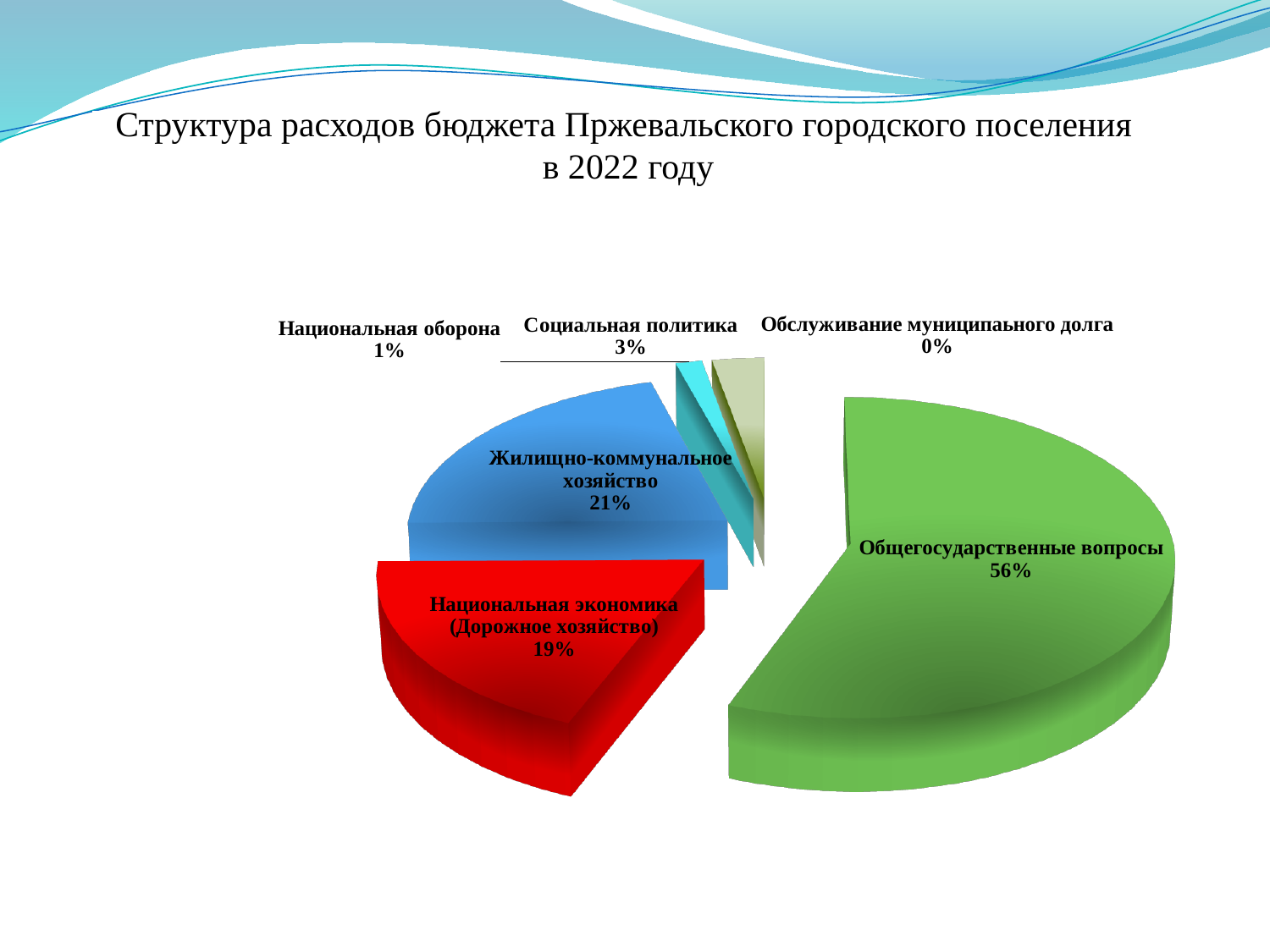
What share of the budget expenditure goes to Общегосударственные вопросы? 56% What is the difference in percentage points between Общегосударственные вопросы and Жилищно-коммунальное хозяйство? 35 Which category has the largest share of the budget expenditure? Общегосударственные вопросы What share of the budget expenditure goes to Жилищно-коммунальное хозяйство? 21% How many categories are shown in the pie chart? 6 What share of the budget expenditure goes to Национальная оборона? 1% What colour is the slice for Национальная экономика (Дорожное хозяйство)? Red What share of the budget expenditure goes to Социальная политика? 3% What share of the budget expenditure goes to Национальная экономика (Дорожное хозяйство)? 19% Which category has the smallest share of the budget expenditure? Обслуживание муниципаьного долга What kind of chart is shown on the slide? Pie chart Which is larger: the share for Жилищно-коммунальное хозяйство or for Национальная экономика (Дорожное хозяйство)? Жилищно-коммунальное хозяйство